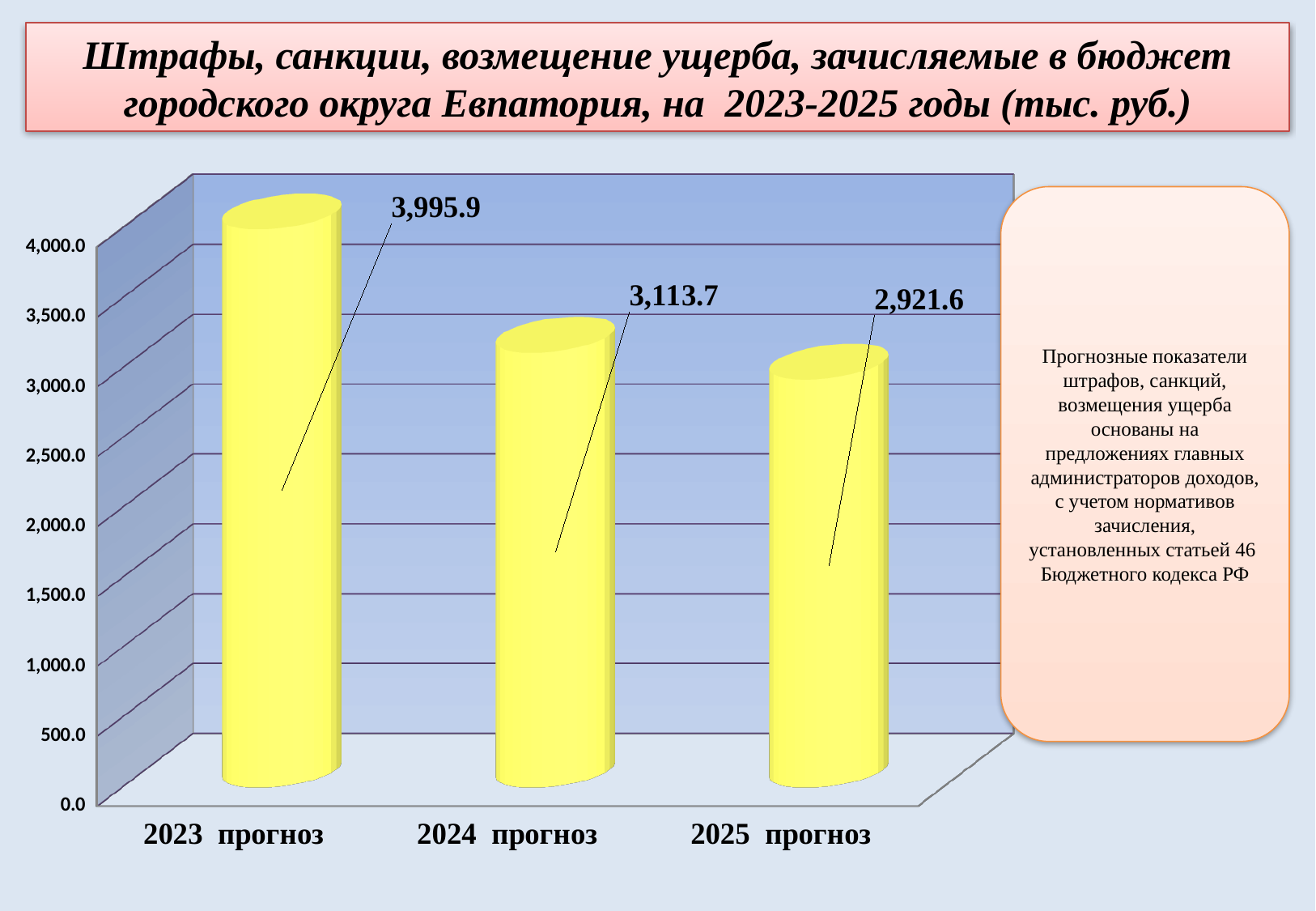
What is the value for 2024 прогноз? 3,113.7 What is the difference between the values for 2023 прогноз and 2024 прогноз? 882.2 What is the difference between the values for 2024 прогноз and 2025 прогноз? 192.1 Which is larger, the value for 2024 прогноз or the value for 2025 прогноз? 2024 прогноз What kind of chart is shown on the slide? bar chart What is the value for 2023 прогноз? 3,995.9 Which category has the lowest value? 2025 прогноз Do the values rise or fall from 2023 прогноз to 2025 прогноз? fall Is the value for 2025 прогноз greater or less than 3,000.0? less How many categories are shown on the x axis? 3 What is the value for 2025 прогноз? 2,921.6 Which category has the highest value? 2023 прогноз